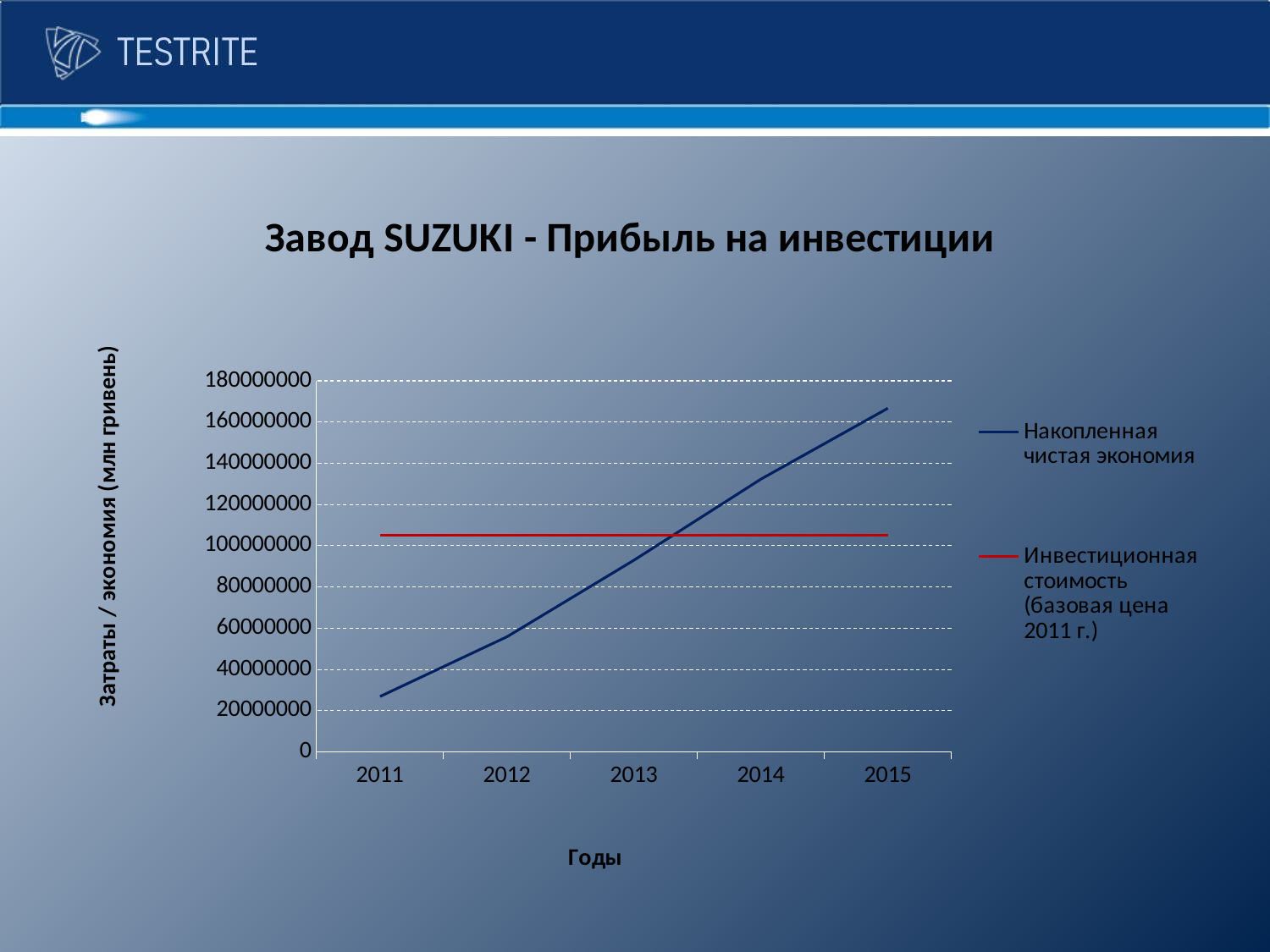
What is the label of the x axis? Годы In 2014, which series has the larger value: 'Накопленная чистая экономия' or 'Инвестиционная стоимость (базовая цена 2011 г.)'? Накопленная чистая экономия What is the title of the chart? Завод SUZUKI - Прибыль на инвестиции Is the value of 'Накопленная чистая экономия' in 2015 greater or less than 160000000? greater How many series does the legend list? 2 In which year is 'Накопленная чистая экономия' lowest? 2011 Is the value of 'Накопленная чистая экономия' in 2013 greater or less than 100000000? less What kind of chart is shown on the slide? line chart How many years are shown on the x axis? 5 In which year is 'Накопленная чистая экономия' highest? 2015 Is the value of 'Накопленная чистая экономия' in 2011 greater or less than 40000000? less Does the 'Накопленная чистая экономия' line rise or fall from 2011 to 2015? rise